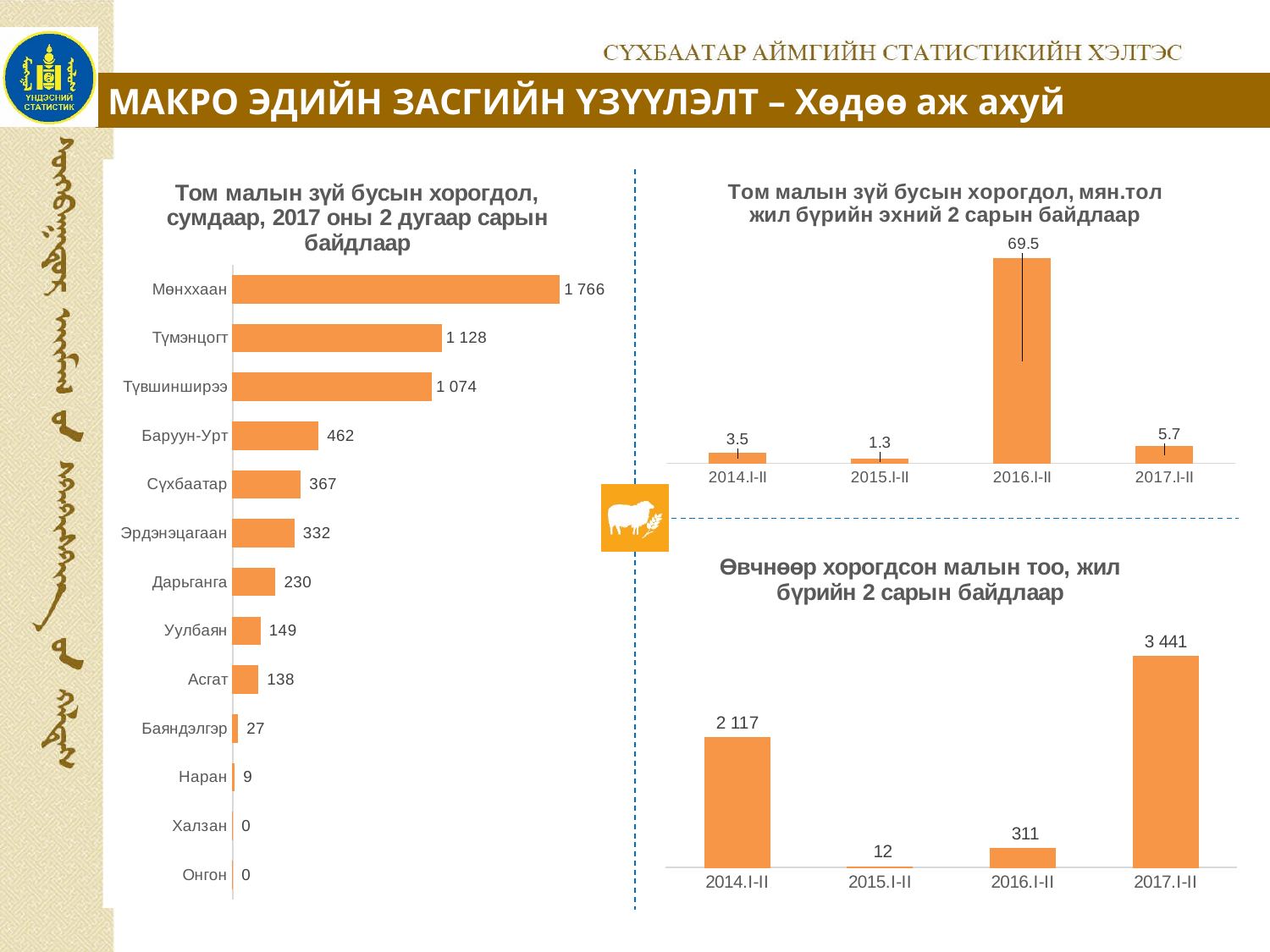
In the top-right chart 'Том малын зүй бусын хорогдол, мян.тол', which period has the lowest value? 2015.I-II In the left chart 'Том малын зүй бусын хорогдол, сумдаар', which category has the highest value? Мөнххаан What type of chart is the left chart 'Том малын зүй бусын хорогдол, сумдаар'? bar chart In the bottom-right chart 'Өвчнөөр хорогдсон малын тоо', how many periods are shown on the x axis? 4 In the bottom-right chart 'Өвчнөөр хорогдсон малын тоо', what is the difference between 2017.I-II and 2014.I-II? 1 324 In the top-right chart 'Том малын зүй бусын хорогдол, мян.тол', what is the value for 2016.I-II? 69.5 In the bottom-right chart 'Өвчнөөр хорогдсон малын тоо', what is the value for 2017.I-II? 3 441 In the left chart 'Том малын зүй бусын хорогдол, сумдаар', which is larger, Баруун-Урт or Сүхбаатар? Баруун-Урт In the left chart 'Том малын зүй бусын хорогдол, сумдаар', what is the value for Мөнххаан? 1 766 In the left chart 'Том малын зүй бусын хорогдол, сумдаар', how many categories are shown? 13 In the left chart 'Том малын зүй бусын хорогдол, сумдаар', what is the value for Дарьганга? 230 In the left chart 'Том малын зүй бусын хорогдол, сумдаар', what is the difference between Түмэнцогт and Түвшинширээ? 54